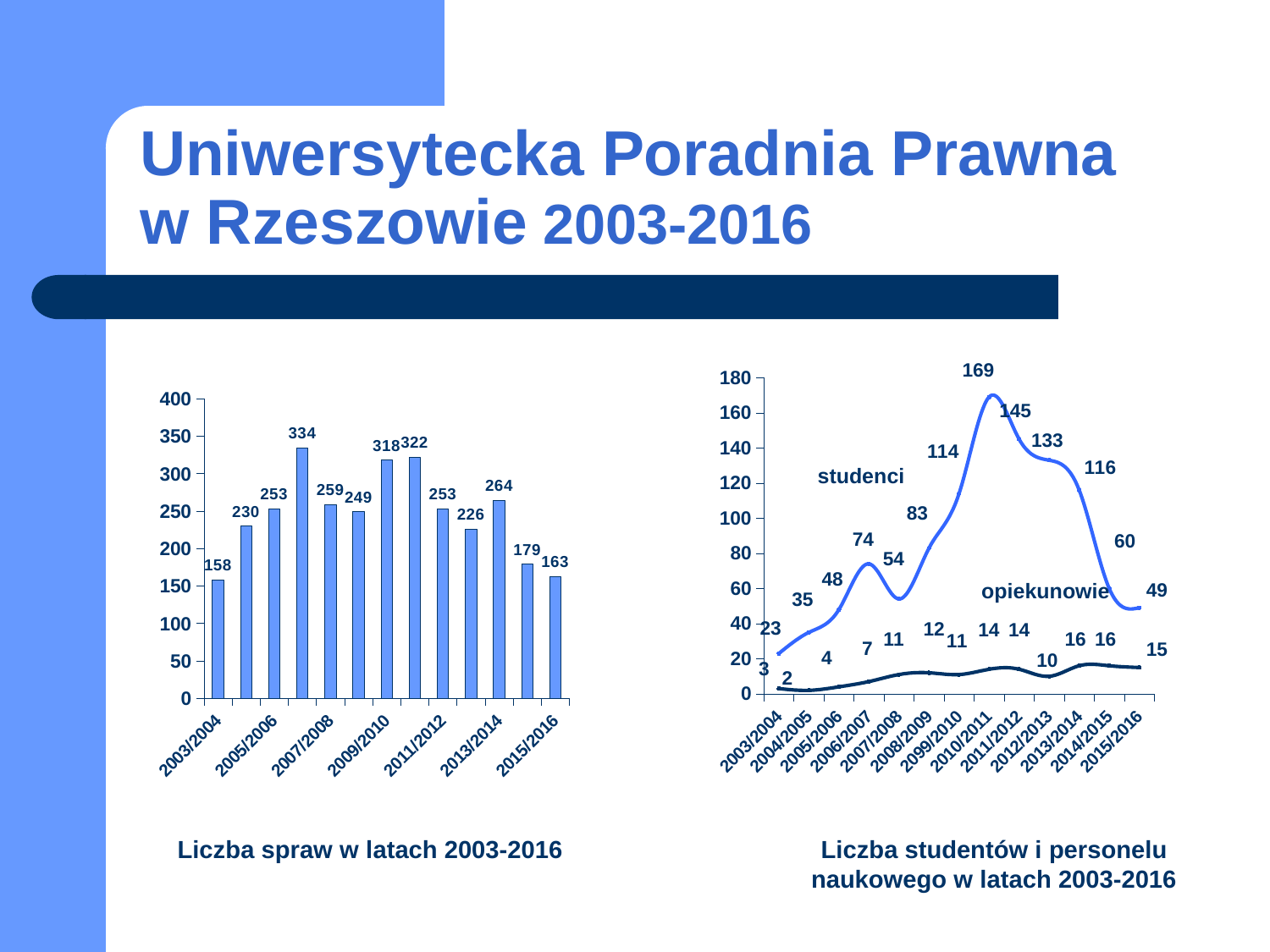
In the right chart 'Liczba studentów i personelu naukowego w latach 2003-2016', how many series are plotted? 2 What kind of chart is the left chart, 'Liczba spraw w latach 2003-2016'? bar chart In the right chart 'Liczba studentów i personelu naukowego w latach 2003-2016', what is the value of 'studenci' for 2003/2004? 23 In the right chart 'Liczba studentów i personelu naukowego w latach 2003-2016', in which year does the 'studenci' series reach its highest value? 2010/2011 In the left chart 'Liczba spraw w latach 2003-2016', how many bars are plotted? 13 What kind of chart is the right chart, 'Liczba studentów i personelu naukowego w latach 2003-2016'? line chart In the left chart 'Liczba spraw w latach 2003-2016', what is the difference between the values for 2007/2008 and 2003/2004? 101 In the left chart 'Liczba spraw w latach 2003-2016', which year has the lowest value? 2003/2004 In the left chart 'Liczba spraw w latach 2003-2016', which year has the highest value? 2006/2007 In the left chart 'Liczba spraw w latach 2003-2016', what is the value for 2015/2016? 163 In the right chart 'Liczba studentów i personelu naukowego w latach 2003-2016', what is the value of 'opiekunowie' for 2015/2016? 15 In the left chart 'Liczba spraw w latach 2003-2016', which is larger, the value for 2009/2010 or for 2011/2012? 2009/2010